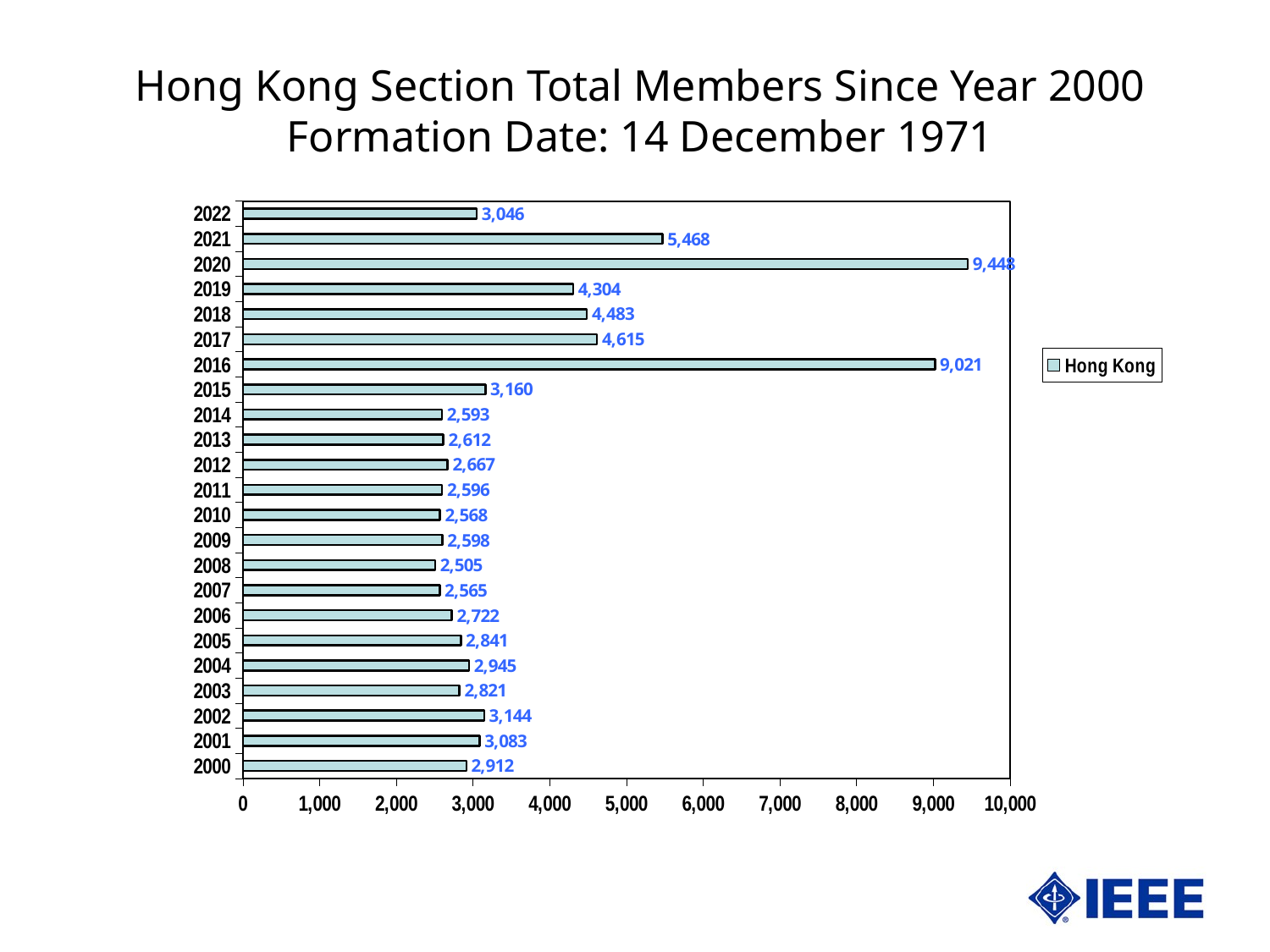
What was the Hong Kong Section total membership in 2021? 5,468 What was the Hong Kong Section total membership in 2022? 3,046 What type of chart is shown on the slide? bar chart What was the Hong Kong Section total membership in 2016? 9,021 What is the difference in total members between 2021 and 2022? 2,422 Which year had more members, 2017 or 2019? 2017 Is the value for 2020 greater or less than 9,000? greater How many years are shown in the chart? 23 Which year had the lowest total membership? 2008 What was the Hong Kong Section total membership in 2000? 2,912 Which year had the highest total membership? 2020 How many series does the legend list? 1